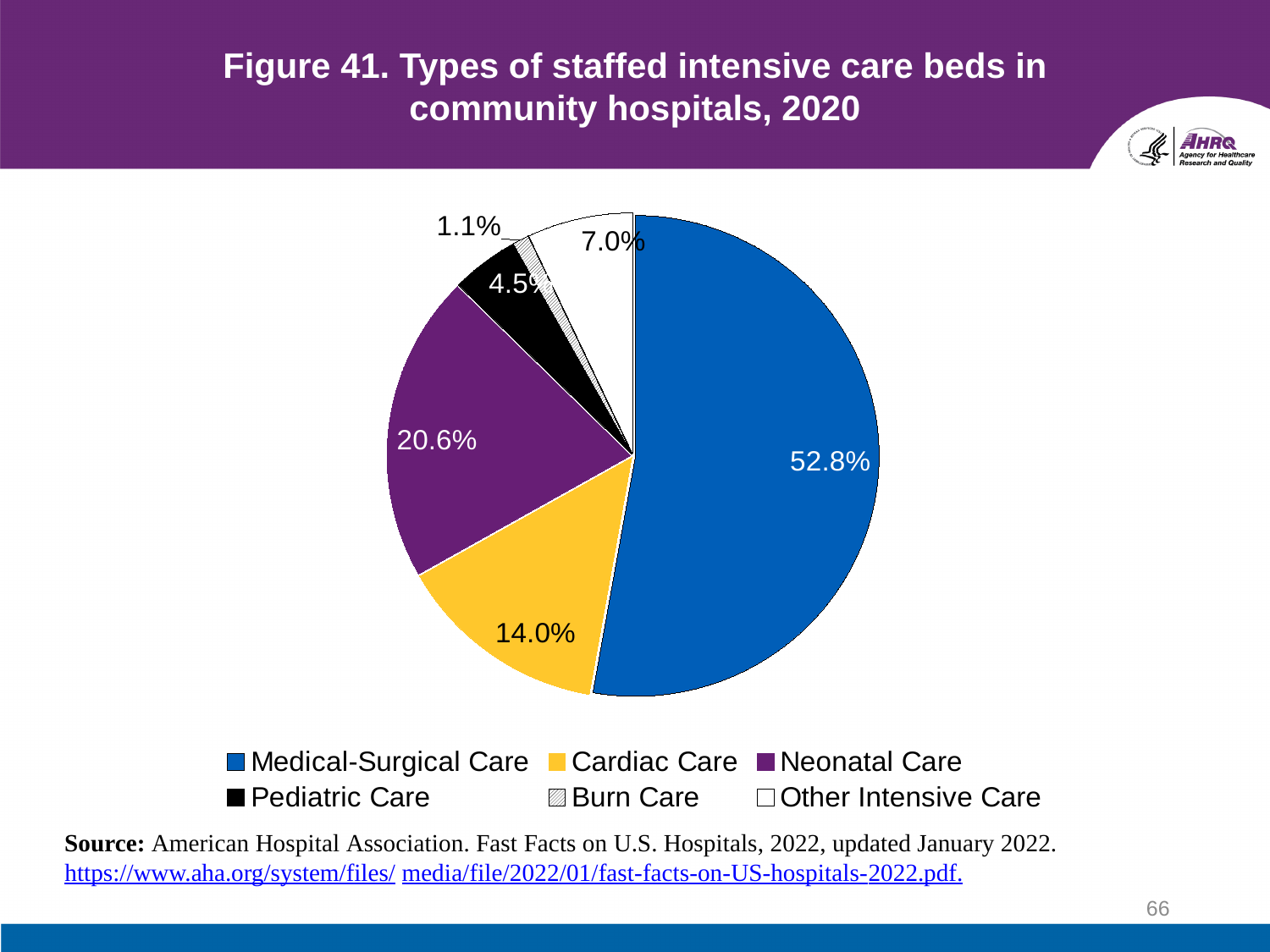
What percentage is shown for Other Intensive Care? 7.0% What percentage is shown for Pediatric Care? 4.5% What share of staffed intensive care beds is Medical-Surgical Care? 52.8% Which type of intensive care bed has the smallest share? Burn Care How many categories does the pie chart show? 6 What percentage of the pie is Neonatal Care? 20.6% What kind of chart is shown on the slide? Pie chart What share of the pie is Burn Care? 1.1% What is the difference in percentage points between Neonatal Care and Cardiac Care? 6.6 Which is larger, Other Intensive Care or Pediatric Care? Other Intensive Care What is the value shown for Cardiac Care? 14.0% Which type of intensive care bed has the largest share? Medical-Surgical Care